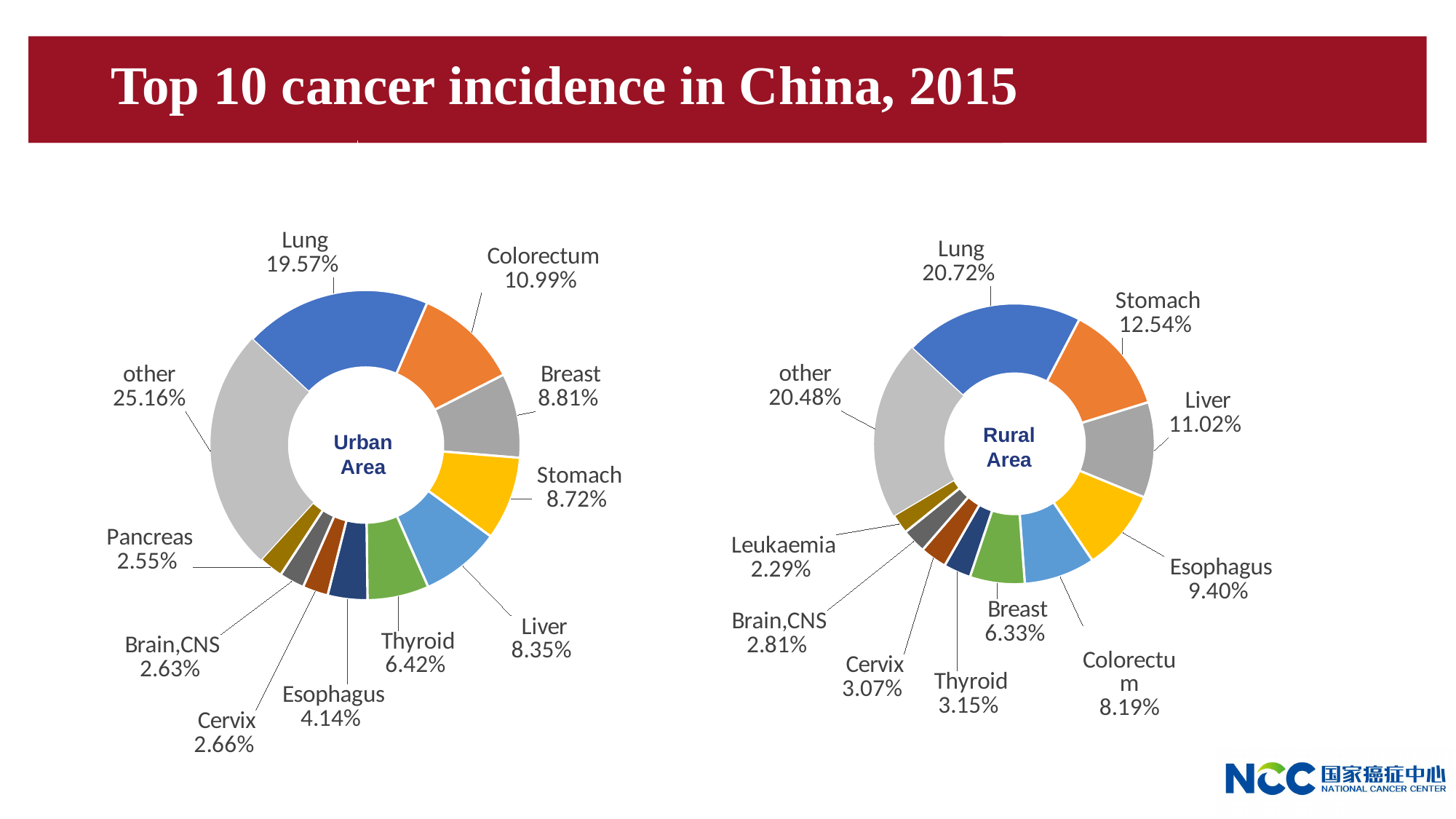
What is the difference between the Lung share in the Rural Area chart and the Lung share in the Urban Area chart? 1.15 percentage points In the Rural Area chart, which named cancer type has the smallest share? Leukaemia In the Rural Area chart, what is the value for Leukaemia? 2.29% How many slices does the Urban Area chart have? 11 What kind of chart is used for the Rural Area? Pie (donut) chart In the Rural Area chart, which is larger, Liver or Esophagus? Liver Is the Stomach share larger in the Urban Area chart or the Rural Area chart? Rural Area In the Urban Area chart, which named cancer type has the smallest share? Pancreas In the Rural Area chart, what share does Stomach account for? 12.54% In the Urban Area chart, which named cancer type has the largest share? Lung In the Urban Area chart, what is the value for Colorectum? 10.99% In the Urban Area chart, what share does Lung account for? 19.57%